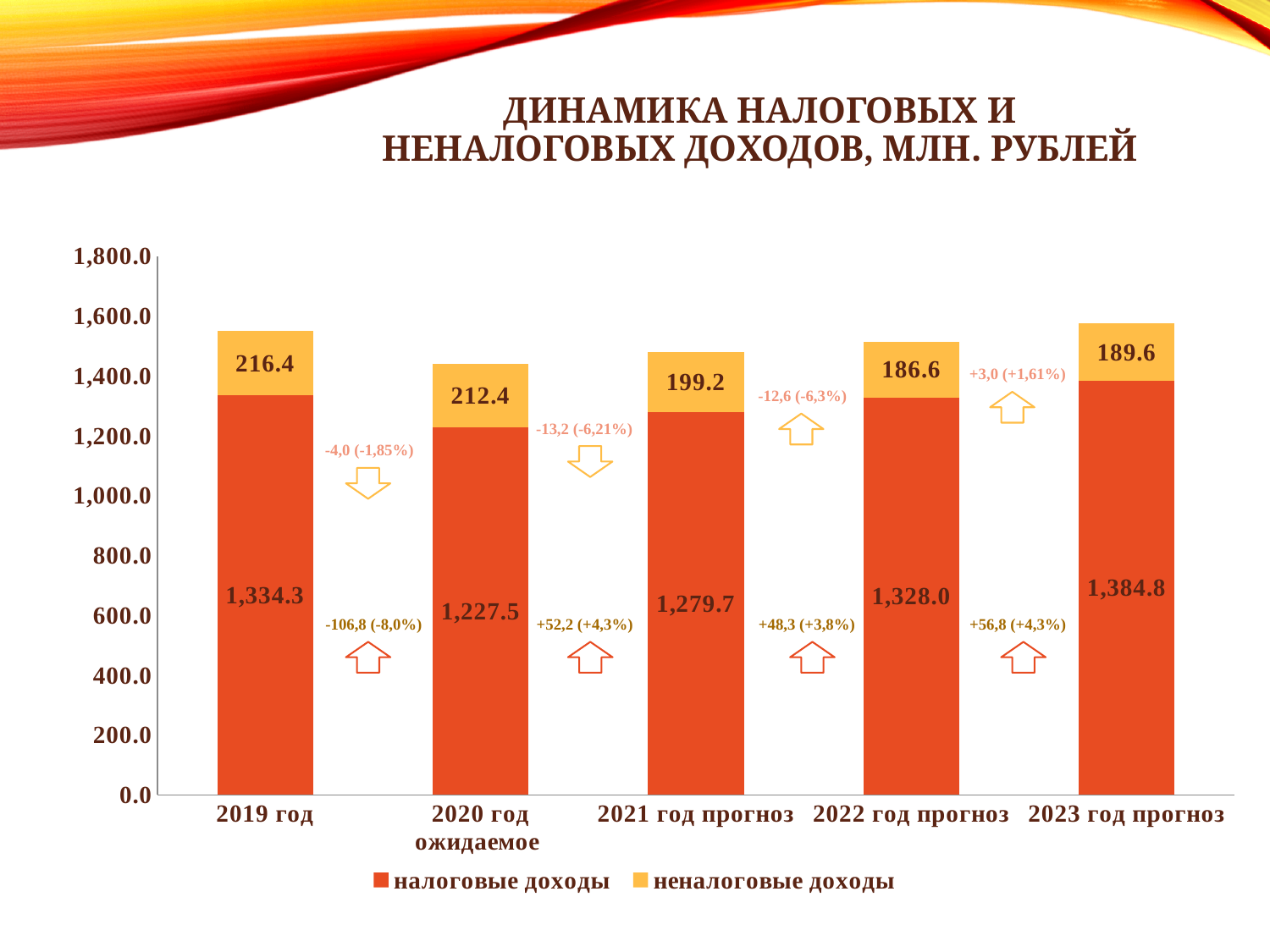
What is the value of неналоговые доходы for 2022 год прогноз? 186.6 What is the total of the stacked bar for 2023 год прогноз? 1,574.4 How many categories are shown on the x axis? 5 What is the value of налоговые доходы for 2020 год ожидаемое? 1,227.5 What is the total of the stacked bar for 2019 год? 1,550.7 What is the value of налоговые доходы for 2019 год? 1,334.3 What is the difference between налоговые доходы in 2023 год прогноз and 2022 год прогноз? 56.8 How many series does the legend list? 2 What kind of chart is shown on the slide? Stacked bar chart Which category has the lowest value of неналоговые доходы? 2022 год прогноз Which is larger: неналоговые доходы in 2019 год or in 2021 год прогноз? 2019 год Which category has the highest value of налоговые доходы? 2023 год прогноз